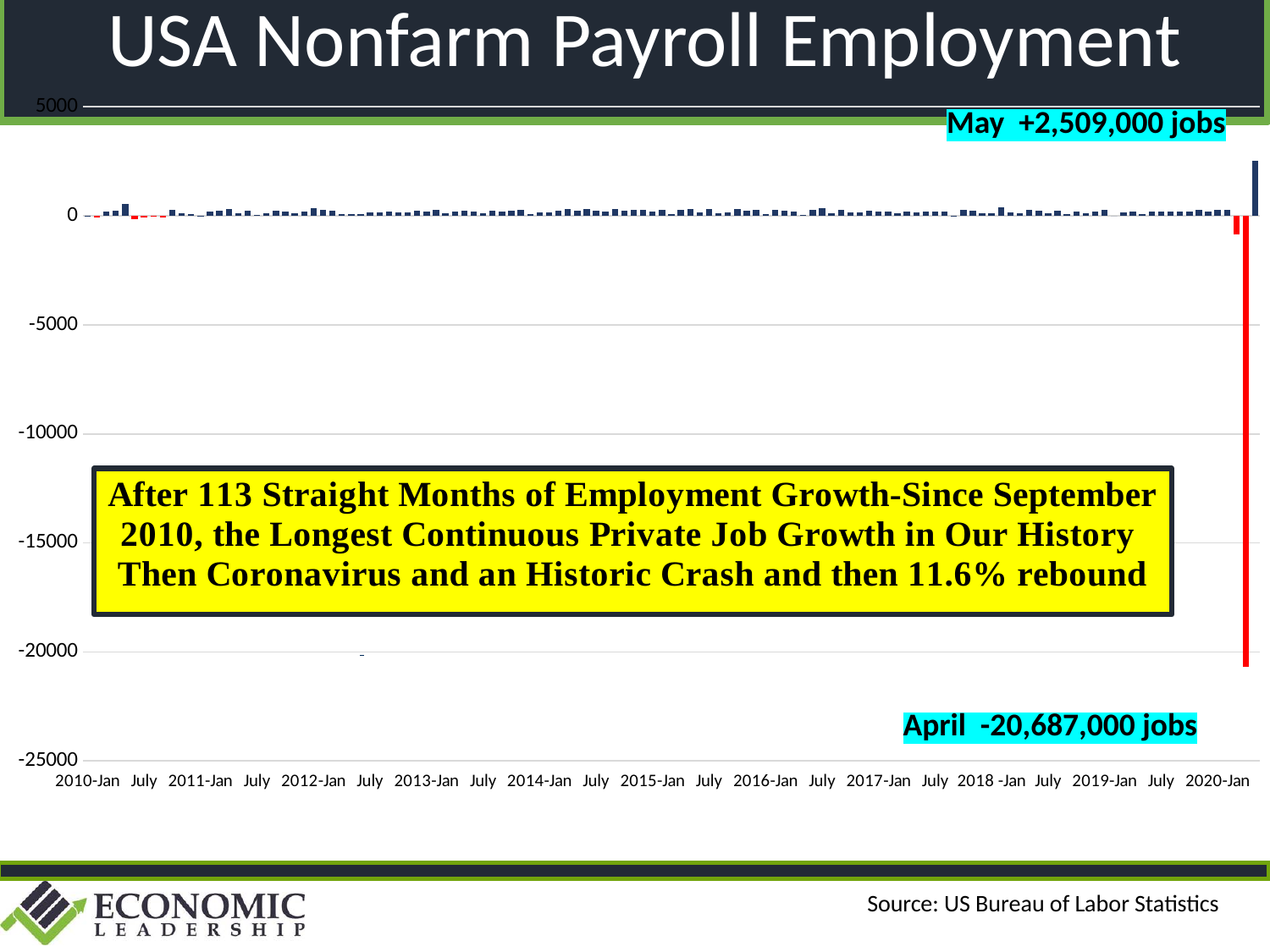
What kind of chart is shown on the slide? bar chart Which month shows the highest value on the chart? May Which is larger, the value for May or the value for April? May According to the annotation, how many jobs were lost in April? -20,687,000 jobs Which month shows the lowest value on the chart? April According to the annotation, how many jobs were added in May? +2,509,000 jobs What is the difference between the May value and the April value? 23,196,000 jobs What is the title of the chart? USA Nonfarm Payroll Employment Is the value for May greater or less than 0? greater Is the value for April greater or less than -15000? less What is the first x-axis label on the chart? 2010-Jan What colour is the bar for April? red